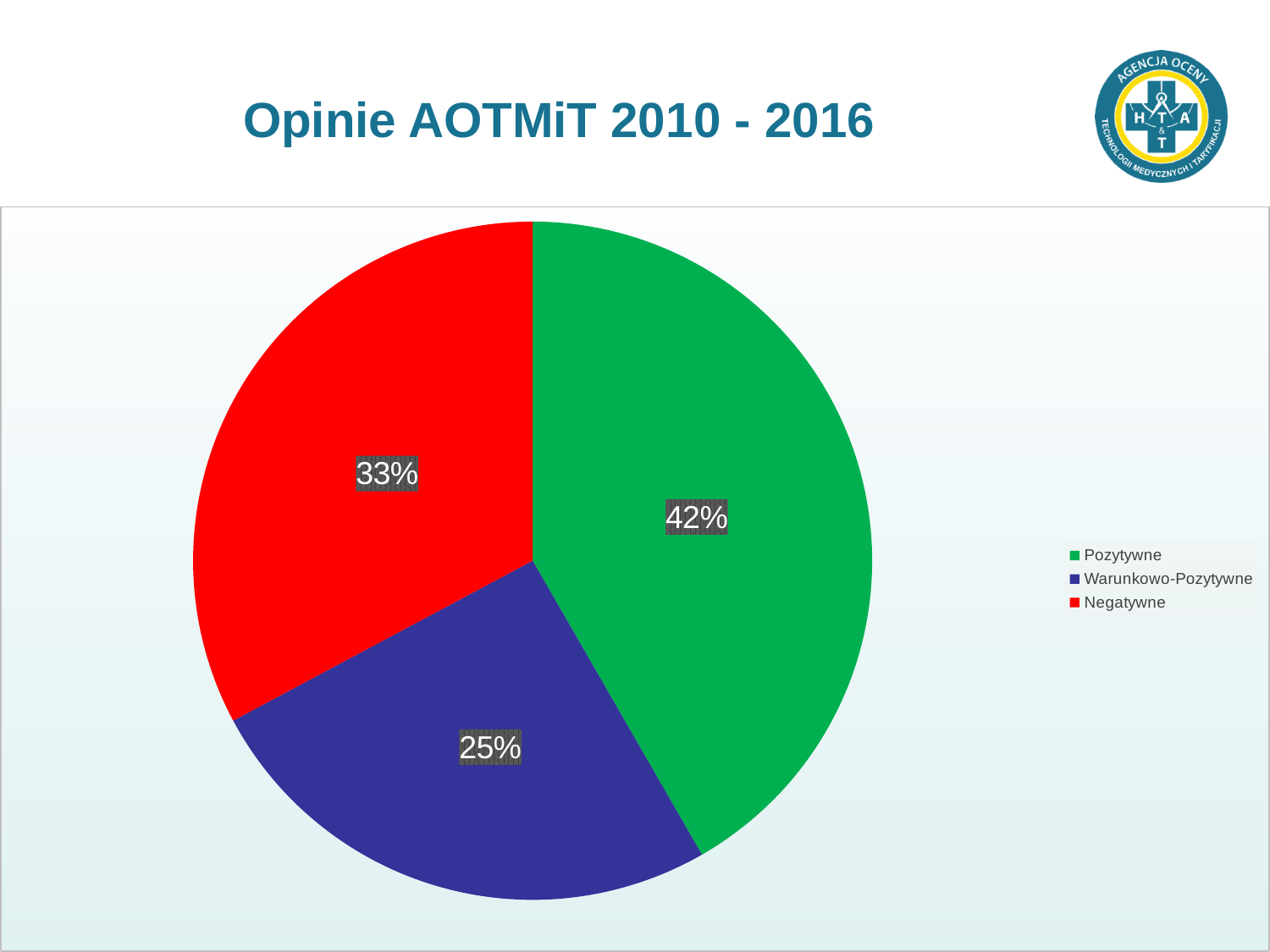
Which is larger, the share for Negatywne or the share for Warunkowo-Pozytywne? Negatywne Which category has the smallest slice of the pie? Warunkowo-Pozytywne What share of the pie does Warunkowo-Pozytywne represent? 25% What is the difference in percentage points between Negatywne and Warunkowo-Pozytywne? 8 What is the difference in percentage points between Pozytywne and Negatywne? 9 Which category has the largest slice of the pie? Pozytywne What share of the pie does Negatywne represent? 33% What colour is the slice for Negatywne? red How many slices does the pie chart have? 3 What share of the pie does Pozytywne represent? 42% What type of chart is shown on the slide? pie chart What is the title of the slide containing the chart? Opinie AOTMiT 2010 - 2016